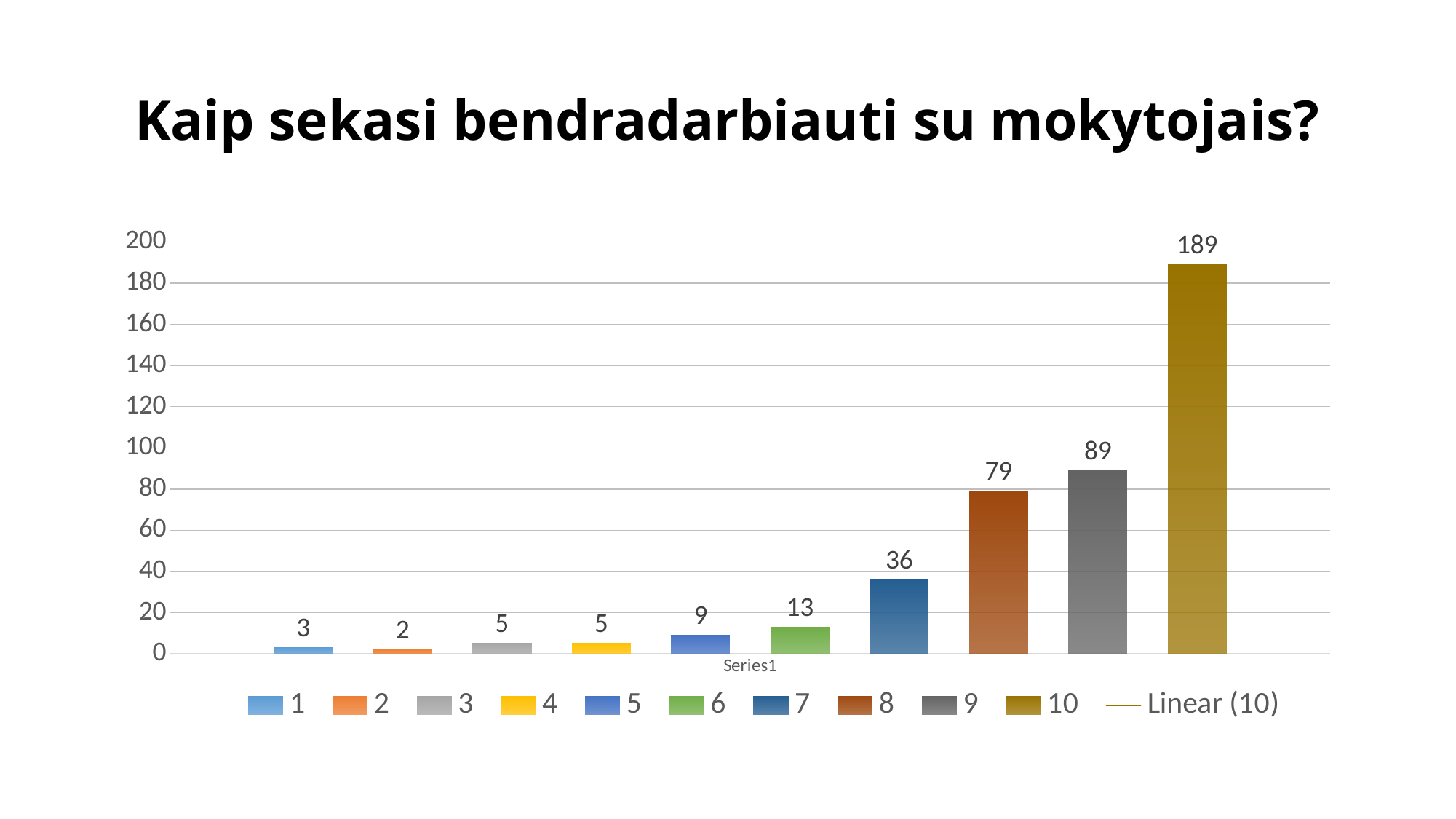
What is the value for series 7? 36 What kind of chart is shown on the slide? bar chart What is the difference between the values for series 10 and series 9? 100 Which series has the highest value? 10 How many bars are plotted in the chart? 10 What is the value for series 6? 13 Which is larger, the value for series 8 or the value for series 9? 9 What is the value for series 10? 189 Which series has the lowest value? 2 What is the title of the chart on the slide? Kaip sekasi bendradarbiauti su mokytojais? What is the difference between the values for series 8 and series 7? 43 Is the value for series 10 greater or less than 180? greater